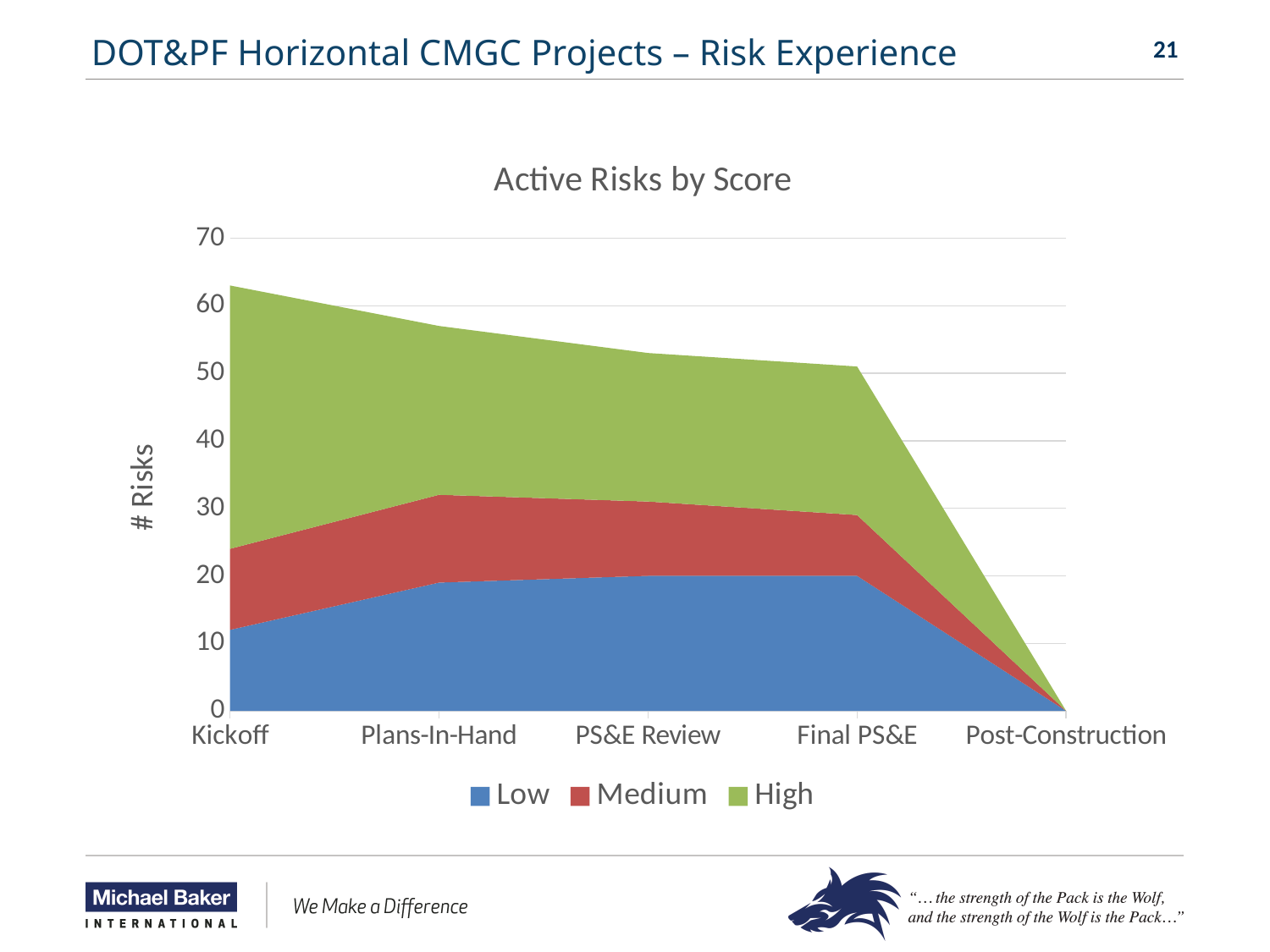
How many project stages are shown along the x axis? 5 Does the total number of active risks rise or fall from Kickoff to Post-Construction? Fall At which stage is the total number of active risks lowest? Post-Construction How many series does the legend list? 3 Is the total number of active risks at Kickoff greater or less than 60? greater Which is larger: the total number of active risks at Plans-In-Hand or at Final PS&E? Plans-In-Hand What is the title of the chart? Active Risks by Score Is the number of Low risks at Kickoff greater or less than 20? less What is the label of the vertical axis? # Risks At which stage is the total number of active risks highest? Kickoff What is the total number of active risks at Post-Construction? 0 What type of chart is shown on the slide? Stacked area chart